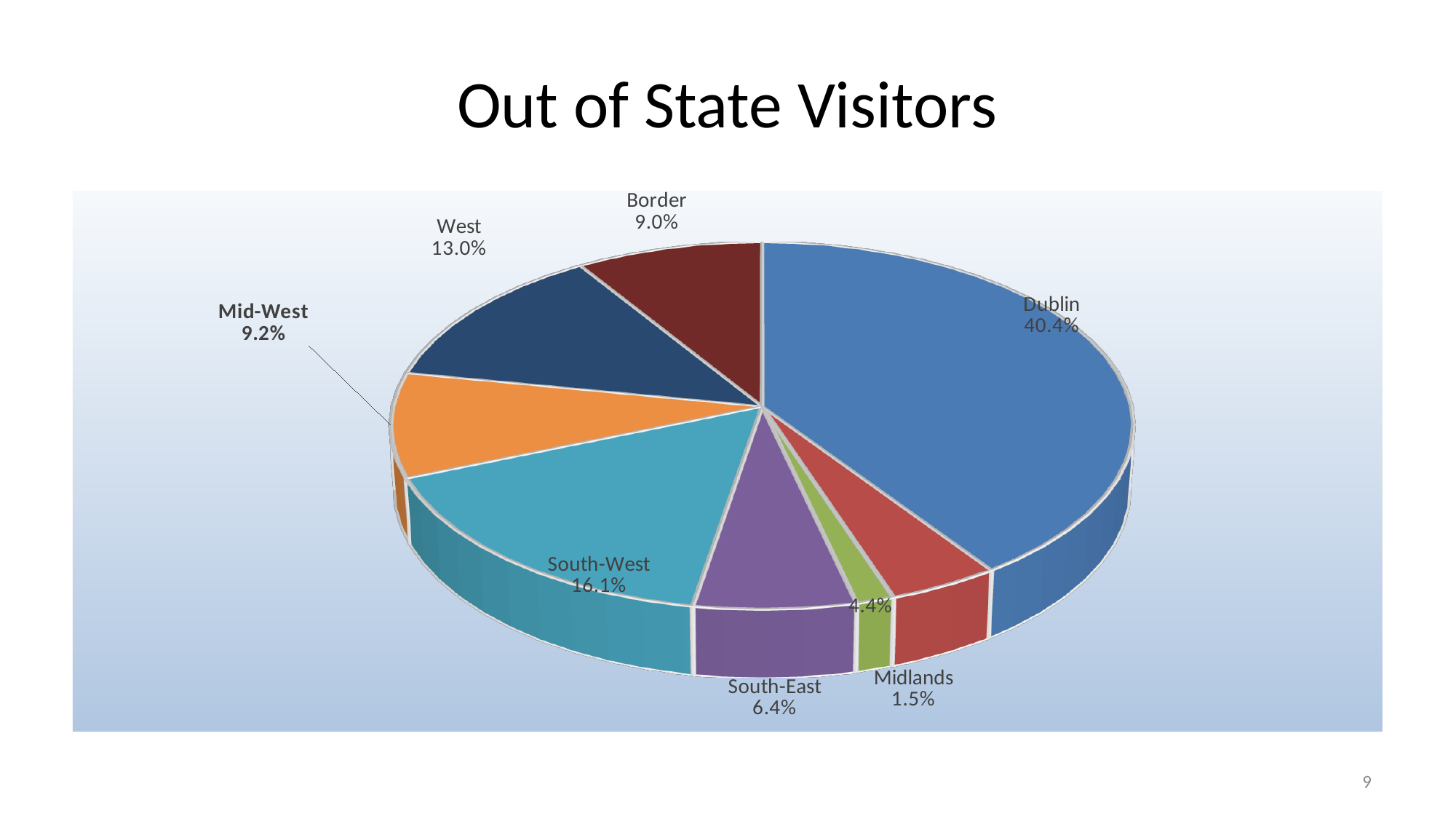
What percentage is shown for the South-West slice? 16.1% What is the difference in percentage points between West and Border? 4.0 Which labelled region has the smallest share of out of state visitors? Midlands What share of out of state visitors does Dublin account for? 40.4% What kind of chart is shown on the slide? Pie chart What is the value shown for Mid-West? 9.2% What is the difference in percentage points between Dublin and South-West? 24.3 What percentage is shown for Midlands? 1.5% Which is larger, the share for South-East or the share for Border? Border How many slices does the pie chart have? 8 What is the title of the chart on the slide? Out of State Visitors Which region has the largest share of out of state visitors? Dublin